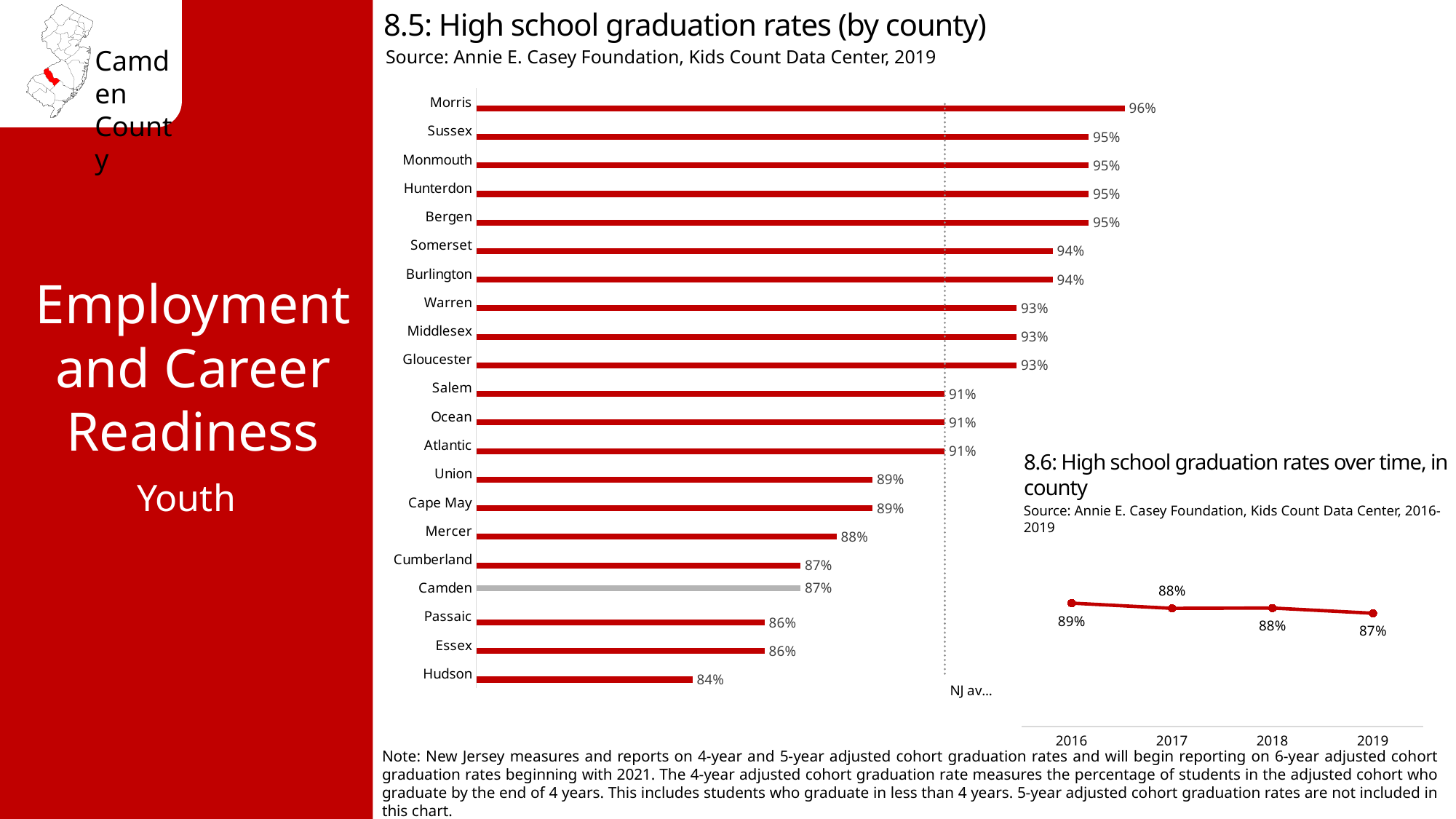
In chart 8.6 (High school graduation rates over time, in county), what was the graduation rate in 2016? 89% In chart 8.6 (High school graduation rates over time, in county), how many years are plotted? 4 In chart 8.5 (High school graduation rates by county), which county's bar is coloured grey instead of red? Camden What kind of chart is chart 8.5 (High school graduation rates by county)? Bar chart In chart 8.5 (High school graduation rates by county), which county has the highest graduation rate? Morris In chart 8.5 (High school graduation rates by county), how many counties are shown? 21 In chart 8.5 (High school graduation rates by county), which county has the lowest graduation rate? Hudson In chart 8.6 (High school graduation rates over time, in county), do graduation rates rise or fall from 2016 to 2019? Fall In chart 8.5 (High school graduation rates by county), what is the difference between the graduation rates of Morris and Hudson? 12% In chart 8.5 (High school graduation rates by county), what is the graduation rate for Gloucester? 93% In chart 8.5 (High school graduation rates by county), which has a higher graduation rate, Mercer or Passaic? Mercer In chart 8.5 (High school graduation rates by county), what is the graduation rate for Camden? 87%